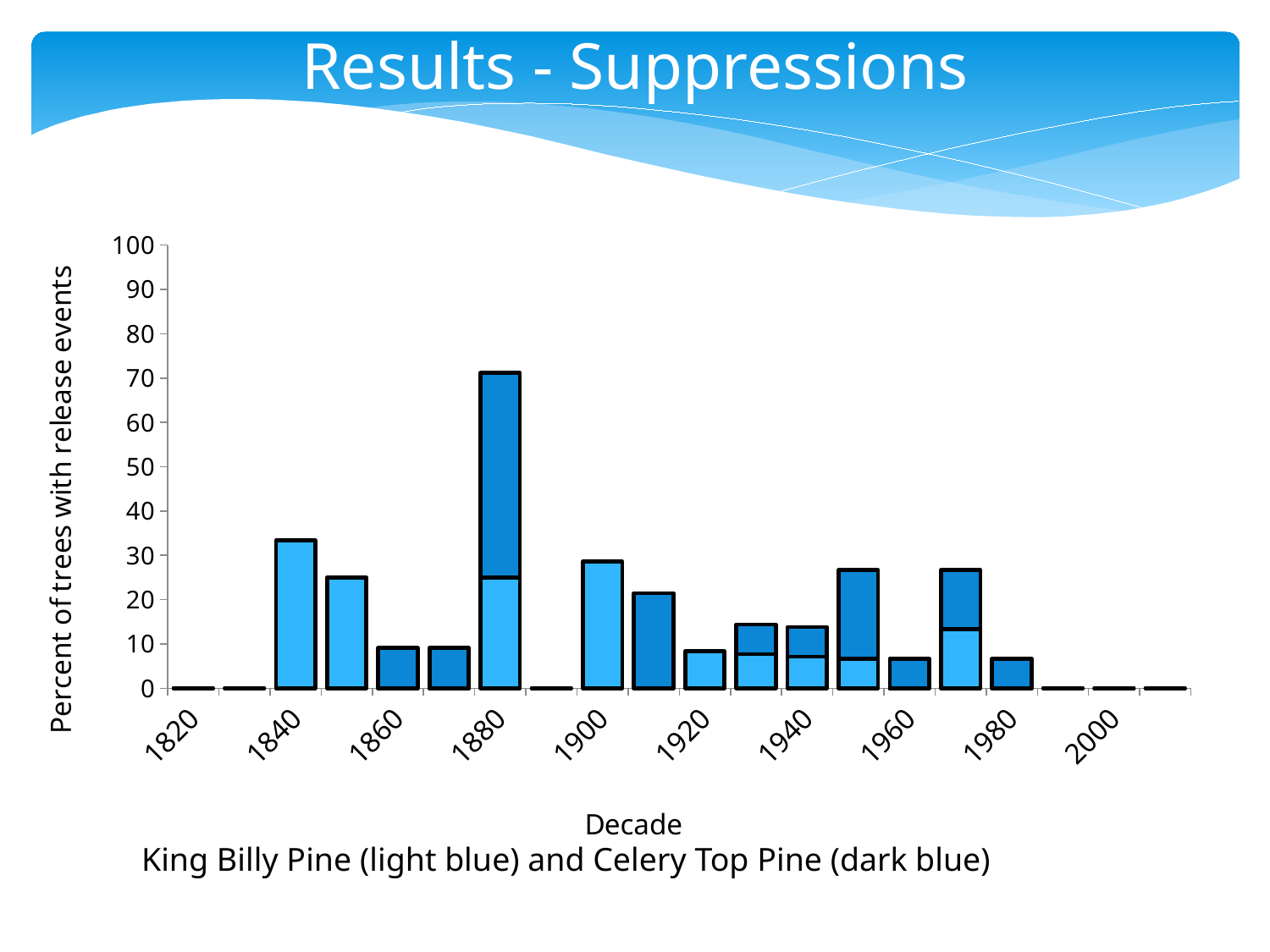
Which species is shown in dark blue? Celery Top Pine Is the value for the 1860 decade greater or less than 20? less Is the total value for the 1950 decade greater or less than 20? greater What kind of chart is shown on the slide? Stacked bar chart Is the total value for the 1880 decade greater or less than 60? greater How many decade labels are shown on the x axis? 10 Which decade has the larger value, 1840 or 1850? 1840 Which decade has the larger total value, 1880 or 1900? 1880 What is the title of the y axis? Percent of trees with release events Which decade has the highest total percent of trees with release events? 1880